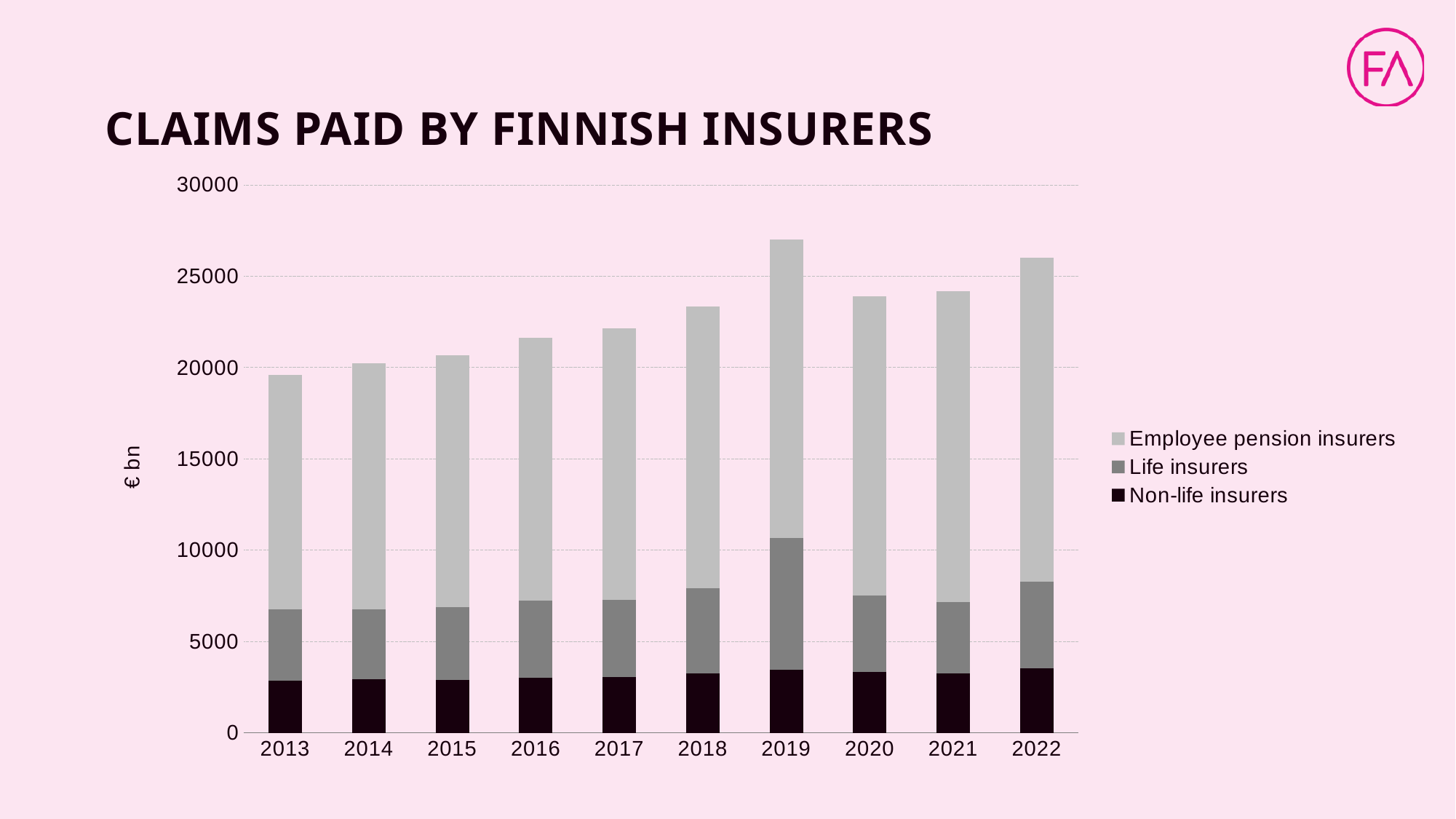
In which year is the Life insurers segment the largest? 2019 Do the total claims paid generally rise or fall from 2013 to 2019? rise Is the total value for 2013 greater or less than 20000? less What is the title of the chart? CLAIMS PAID BY FINNISH INSURERS How many years are shown on the x axis of the chart? 10 Is the total value for 2018 greater or less than 25000? less How many series does the legend list? 3 What kind of chart is shown on the slide? Stacked bar chart Which year has the lowest total claims paid? 2013 Is the total value for 2019 greater or less than 25000? greater Which year has the highest total claims paid? 2019 Which year has a larger total bar, 2019 or 2022? 2019